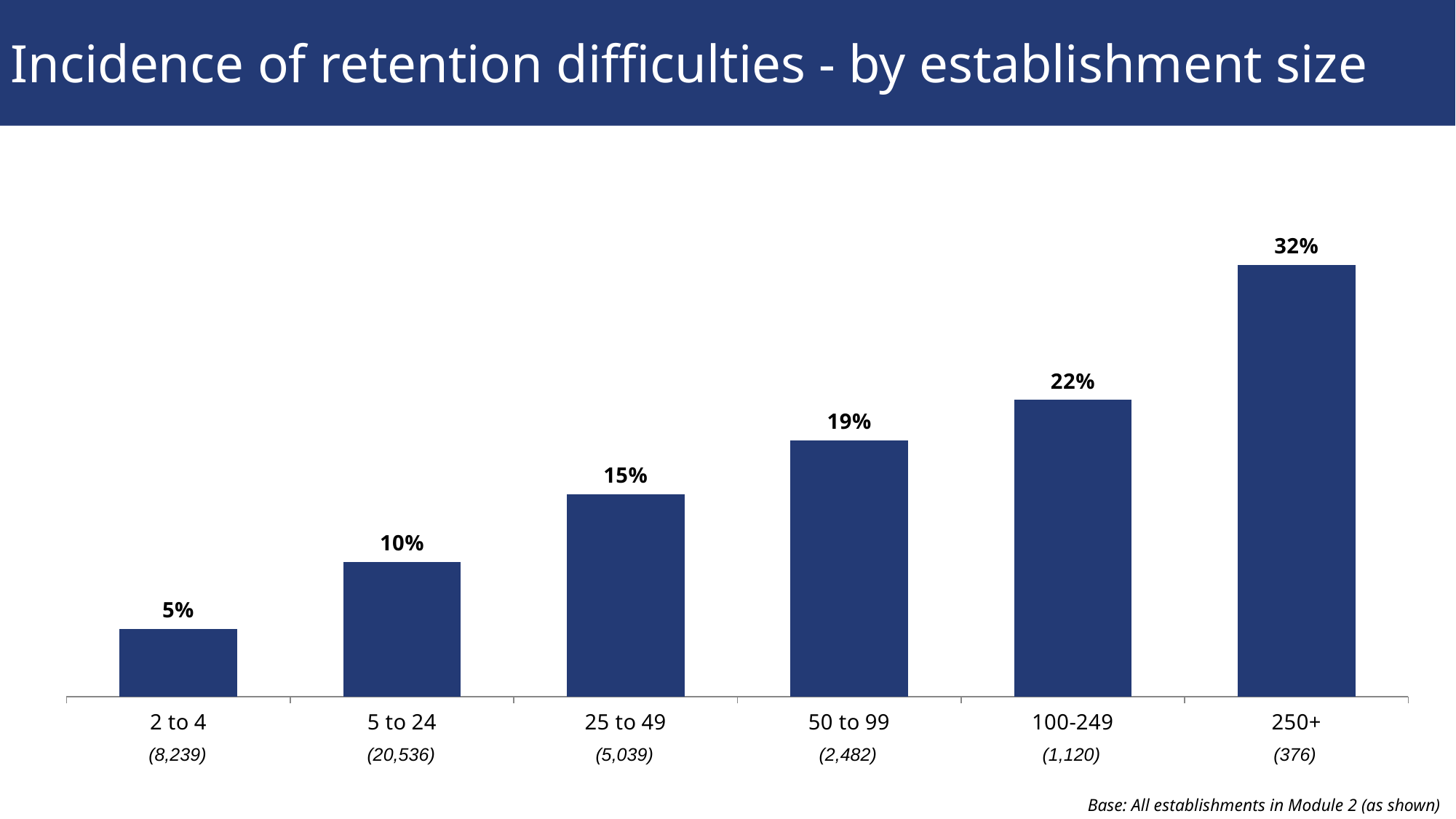
What is the value shown for the 50 to 99 establishment size band? 19% What is the difference between the values for 250+ and 100-249 establishments? 10 percentage points What is the incidence of retention difficulties for establishments with 2 to 4 employees? 5% Which establishment size band has the lowest incidence of retention difficulties? 2 to 4 Which establishment size band has the highest incidence of retention difficulties? 250+ What is the base (number of establishments) shown for the 250+ size band? 376 What is the difference between the values for 25 to 49 and 5 to 24 establishments? 5 percentage points What is the value shown for the 100-249 establishment size band? 22% Which has a higher incidence of retention difficulties: 50 to 99 or 25 to 49 establishments? 50 to 99 What kind of chart is shown on the slide? Bar chart How many establishment size bands are shown on the chart? 6 Do the values rise or fall as establishment size increases along the x axis? Rise